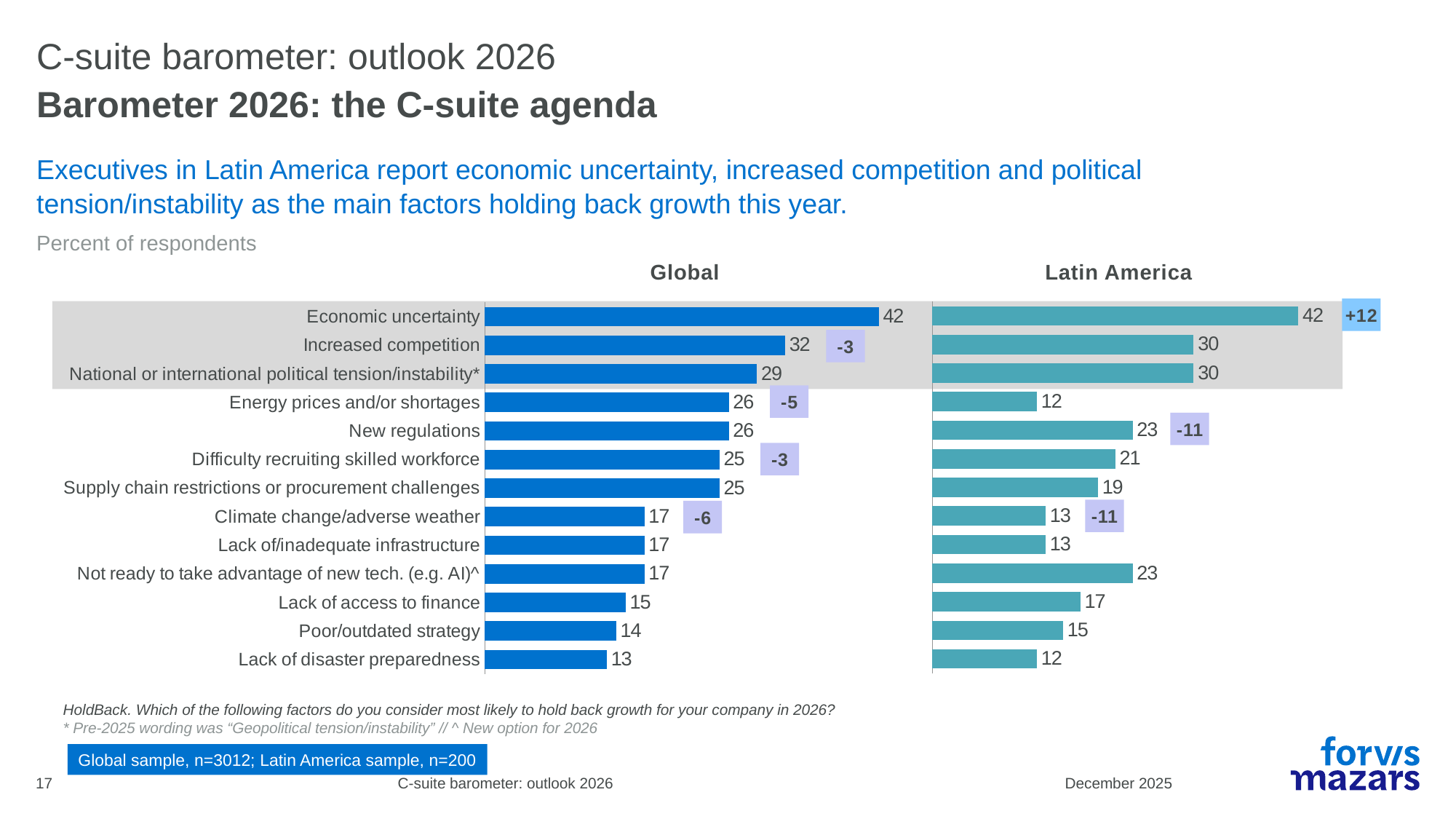
What kind of chart is used to show the Global and Latin America values? Bar chart In the Global chart, which category has the lowest value? Lack of disaster preparedness What is the difference between the Global and Latin America values for Energy prices and/or shortages? 14 Which is larger: the Global value for Climate change/adverse weather or the Latin America value for Climate change/adverse weather? Global How many categories are shown in the Global chart? 13 In the Global chart, which category has the highest value? Economic uncertainty In the Latin America chart, which category has the highest value? Economic uncertainty In the Global chart, what is the value for Economic uncertainty? 42 In the Latin America chart, what is the value for Not ready to take advantage of new tech. (e.g. AI)^? 23 In the Latin America chart, what is the value for Energy prices and/or shortages? 12 Which is larger: the Global value for Lack of access to finance or the Latin America value for Lack of access to finance? Latin America What is the difference between the Global values for Increased competition and Lack of access to finance? 17